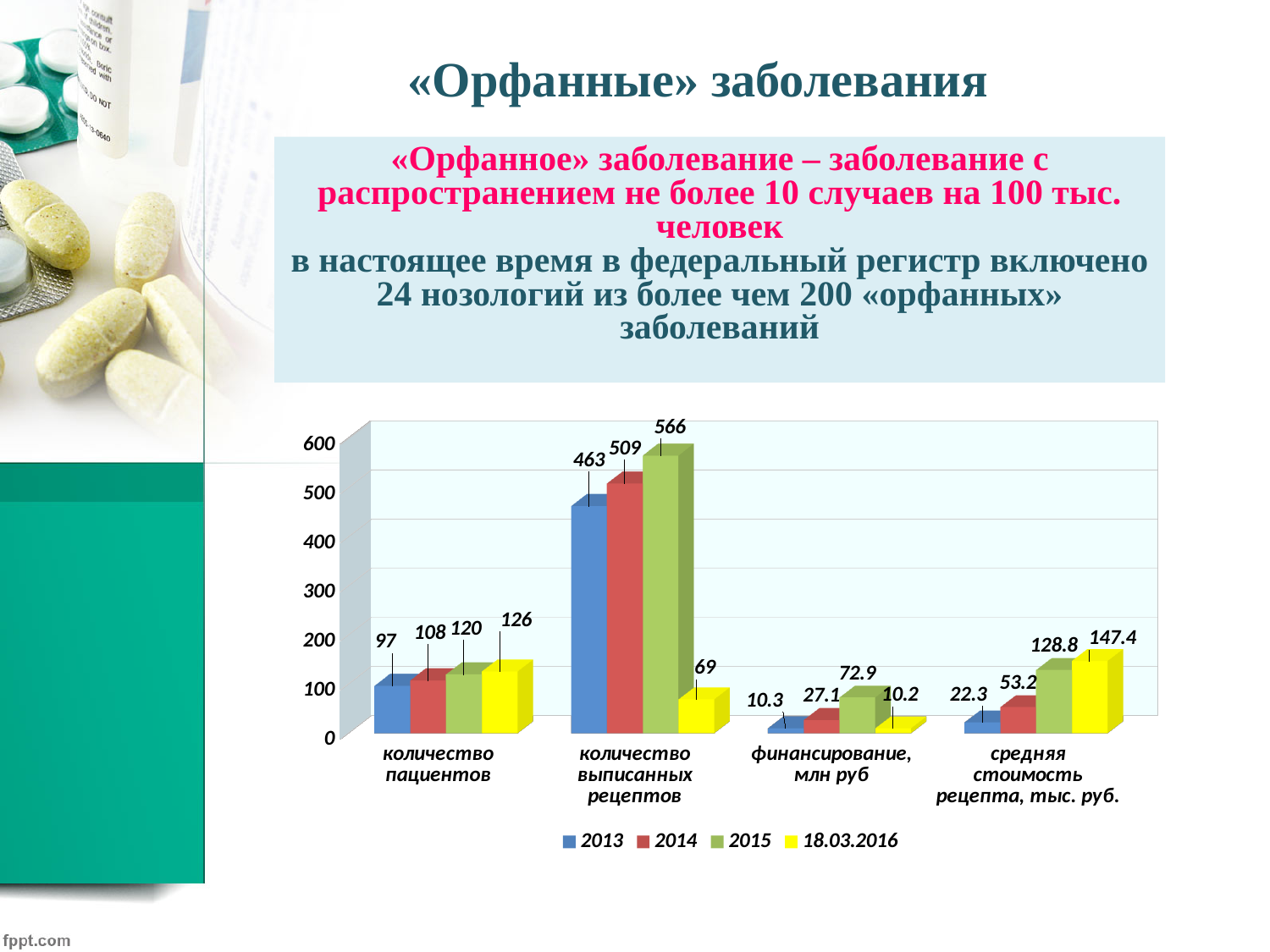
Which series has the highest value in the category «финансирование, млн руб»? 2015 How many categories are shown on the x axis of the chart? 4 Which is larger in the category «средняя стоимость рецепта, тыс. руб.»: the value for 2014 or the value for 2015? 2015 Do the values for «количество пациентов» rise or fall from 2013 to 18.03.2016? rise What is the value for 2013 in the category «средняя стоимость рецепта, тыс. руб.»? 22.3 What is the value for 2014 in the category «финансирование, млн руб»? 27.1 What is the difference between the 2015 and 2013 values in the category «количество пациентов»? 23 What type of chart is shown on the slide? bar chart What is the value for 18.03.2016 in the category «количество пациентов»? 126 What is the value for 2015 in the category «количество выписанных рецептов»? 566 Which series has the lowest value in the category «количество выписанных рецептов»? 18.03.2016 How many series does the chart legend list? 4